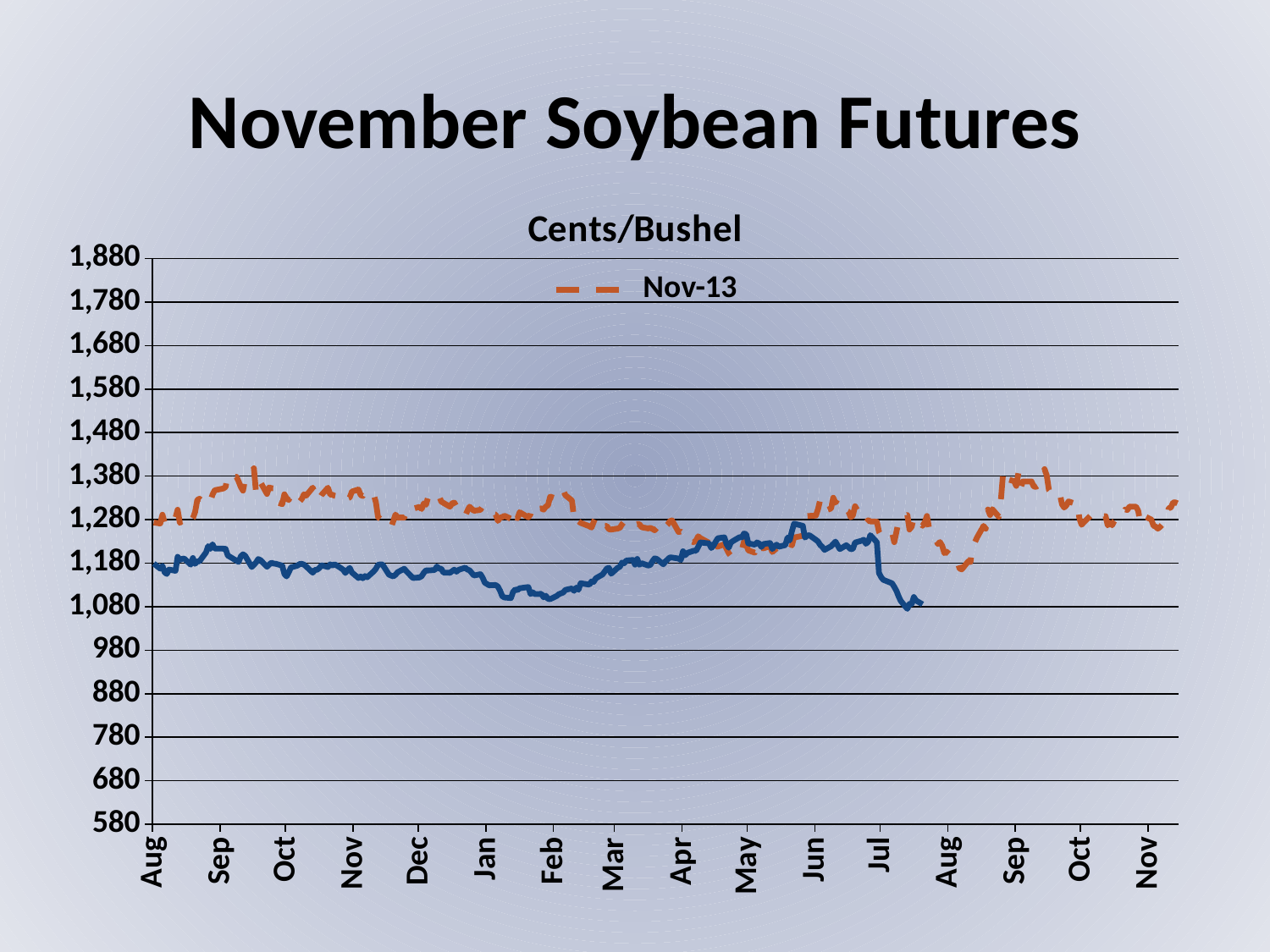
Is the value of the Nov-13 series at the second Aug greater or less than 1,280? less Is the value of the Nov-13 series at Sep (the first Sep) greater or less than 1,280? greater Is the value of the solid blue line at Feb greater or less than 1,180? less What series name appears in the legend? Nov-13 How many month labels are shown along the x axis? 16 What is the title of the chart? Cents/Bushel Does the Nov-13 series rise or fall between the second Aug and the second Sep? rise Which line is higher at Dec, the Nov-13 dashed line or the solid blue line? Nov-13 dashed line What kind of chart is shown on the slide? line chart How many series does the legend list? 1 Does the solid blue line rise or fall between Jun and Jul? fall